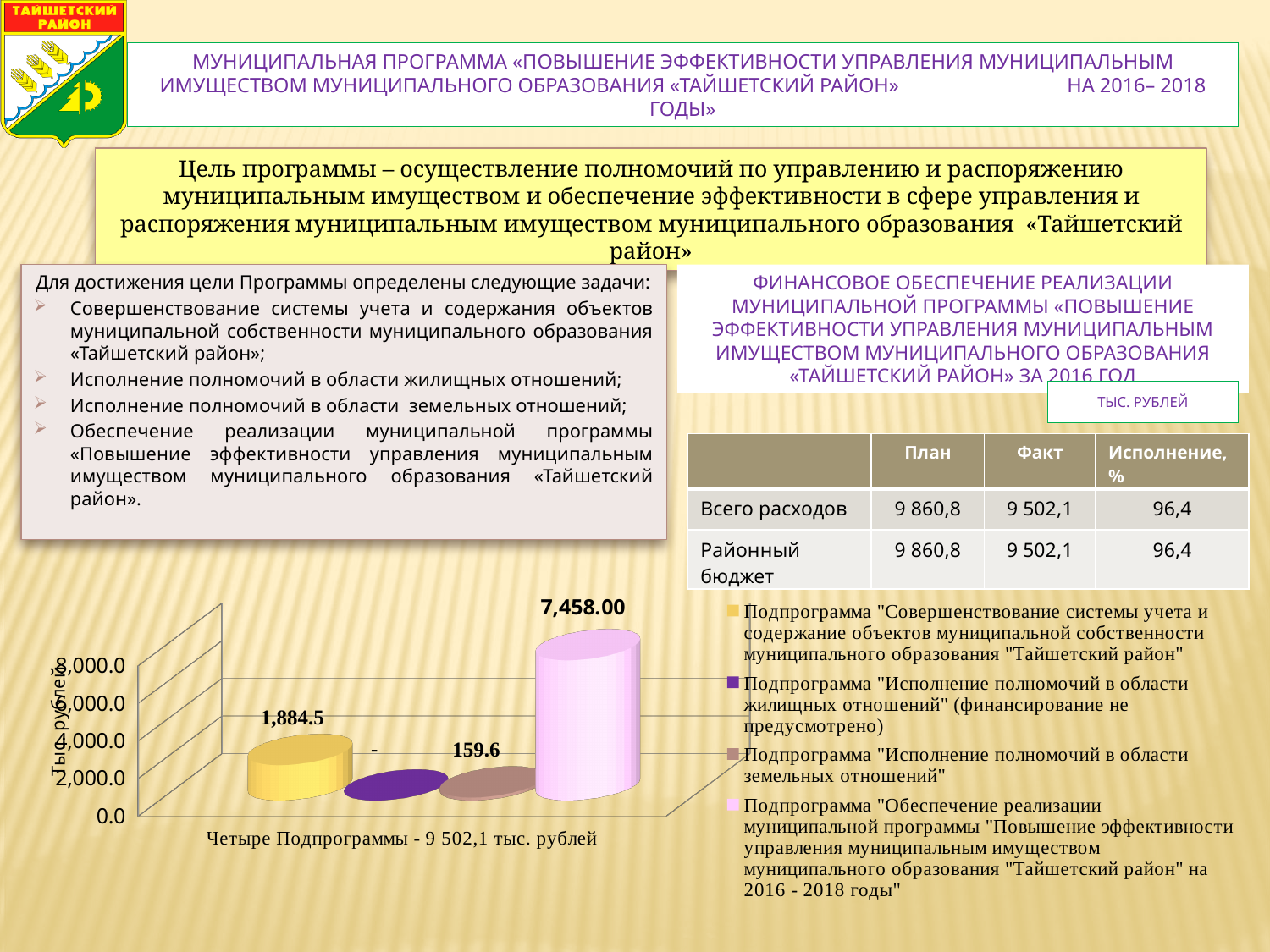
According to the caption under the chart, what is the total for the four subprograms? 9 502,1 тыс. рублей What is the value shown for the subprogram "Исполнение полномочий в области земельных отношений"? 159.6 How many series does the chart legend list? 4 What is the value shown for the subprogram "Совершенствование системы учета и содержание объектов муниципальной собственности муниципального образования "Тайшетский район""? 1,884.5 What is the difference between the value for the subprogram "Обеспечение реализации муниципальной программы..." (7,458.00) and the subprogram "Совершенствование системы учета..." (1,884.5)? 5,573.5 Is the value for the subprogram "Обеспечение реализации муниципальной программы..." greater or less than 6,000.0? greater What type of chart is shown on the slide? Bar chart Which subprogram has the smallest non-zero value in the chart? Подпрограмма "Исполнение полномочий в области земельных отношений" Which is larger: the value for the subprogram "Совершенствование системы учета..." or the subprogram "Исполнение полномочий в области земельных отношений"? Подпрограмма "Совершенствование системы учета..." What is the value shown for the subprogram "Обеспечение реализации муниципальной программы "Повышение эффективности управления муниципальным имуществом муниципального образования "Тайшетский район" на 2016 - 2018 годы""? 7,458.00 Which subprogram has the highest value in the chart? Подпрограмма "Обеспечение реализации муниципальной программы "Повышение эффективности управления муниципальным имуществом муниципального образования "Тайшетский район" на 2016 - 2018 годы" What is the label on the vertical axis of the chart? Тыс. рублей